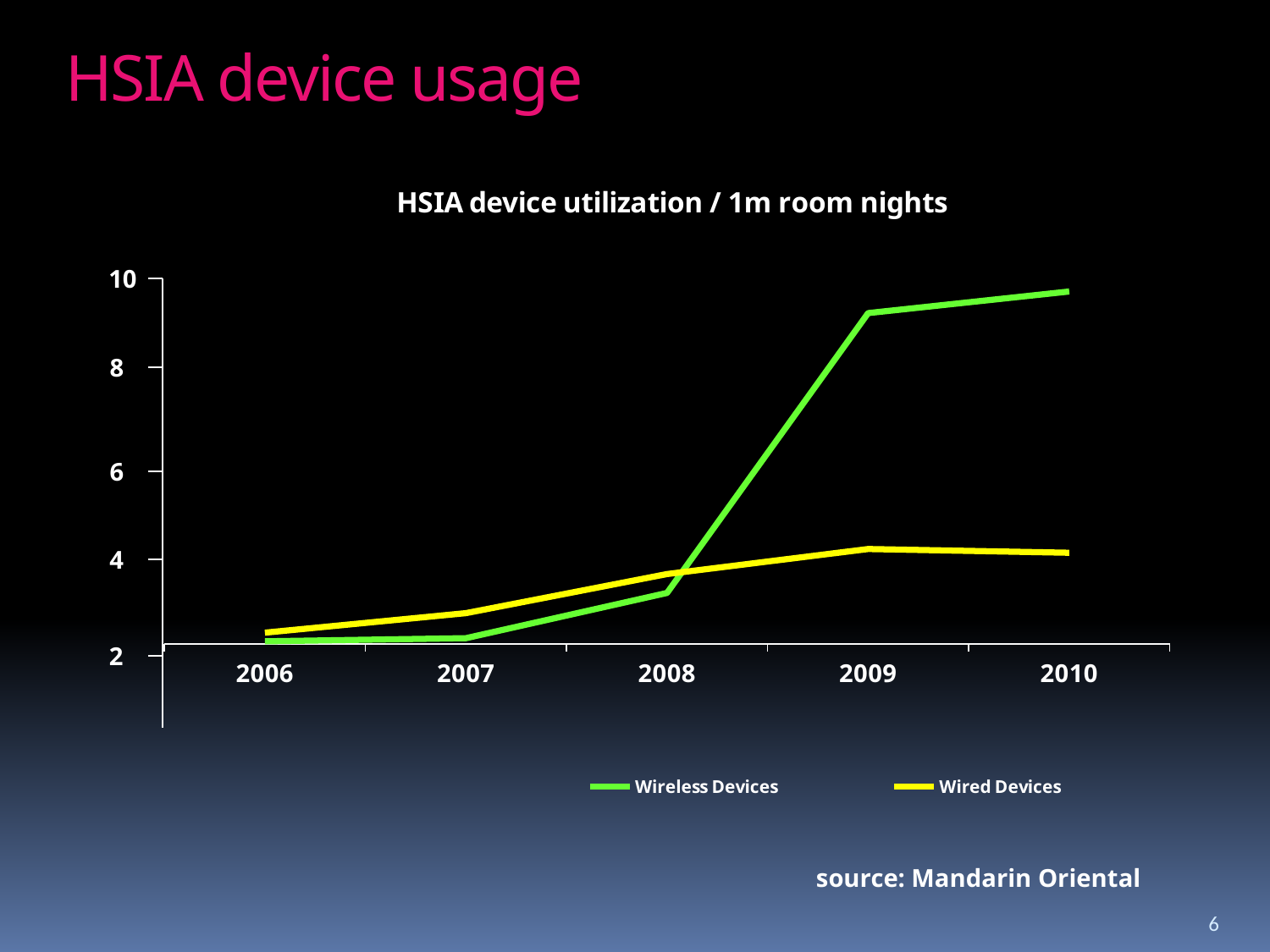
Is the value for Wireless Devices in 2008 greater or less than 4? less Is the value for Wireless Devices in 2009 greater or less than 8? greater In 2007, which series has the higher value, Wireless Devices or Wired Devices? Wired Devices What kind of chart is shown on the slide? line chart Is the value for Wired Devices in 2010 greater or less than 6? less How many series does the legend list? 2 How many years are plotted along the x axis? 5 What is the title of the chart? HSIA device utilization / 1m room nights In which year is the Wireless Devices value highest? 2010 Do the Wireless Devices values rise or fall from 2006 to 2010? rise What colour is the Wired Devices line? yellow In 2010, which series has the higher value, Wireless Devices or Wired Devices? Wireless Devices